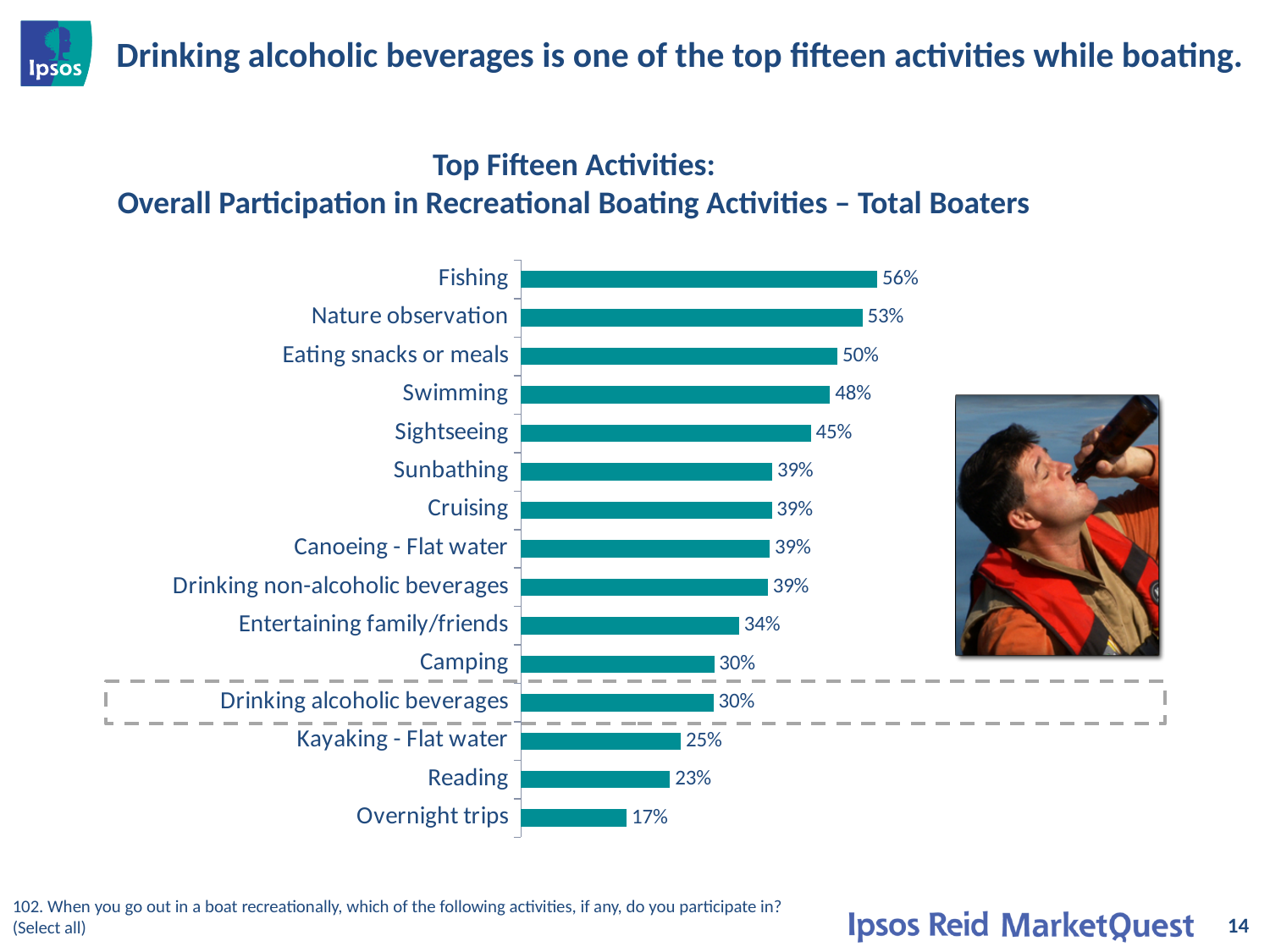
What percentage of boaters participate in Fishing? 56% How many activities are shown in the chart? 15 Which has a higher value, Sightseeing or Reading? Sightseeing What is the value shown for Entertaining family/friends? 34% What percentage of boaters participate in Overnight trips? 17% What type of chart is shown on the slide? Bar chart Which activity has the lowest participation? Overnight trips Which activity is highlighted with a dashed box on the chart? Drinking alcoholic beverages What is the difference in percentage points between Swimming and Camping? 18 What is the difference in percentage points between Fishing and Overnight trips? 39 Which activity has the highest participation? Fishing What is the value shown for Drinking alcoholic beverages? 30%